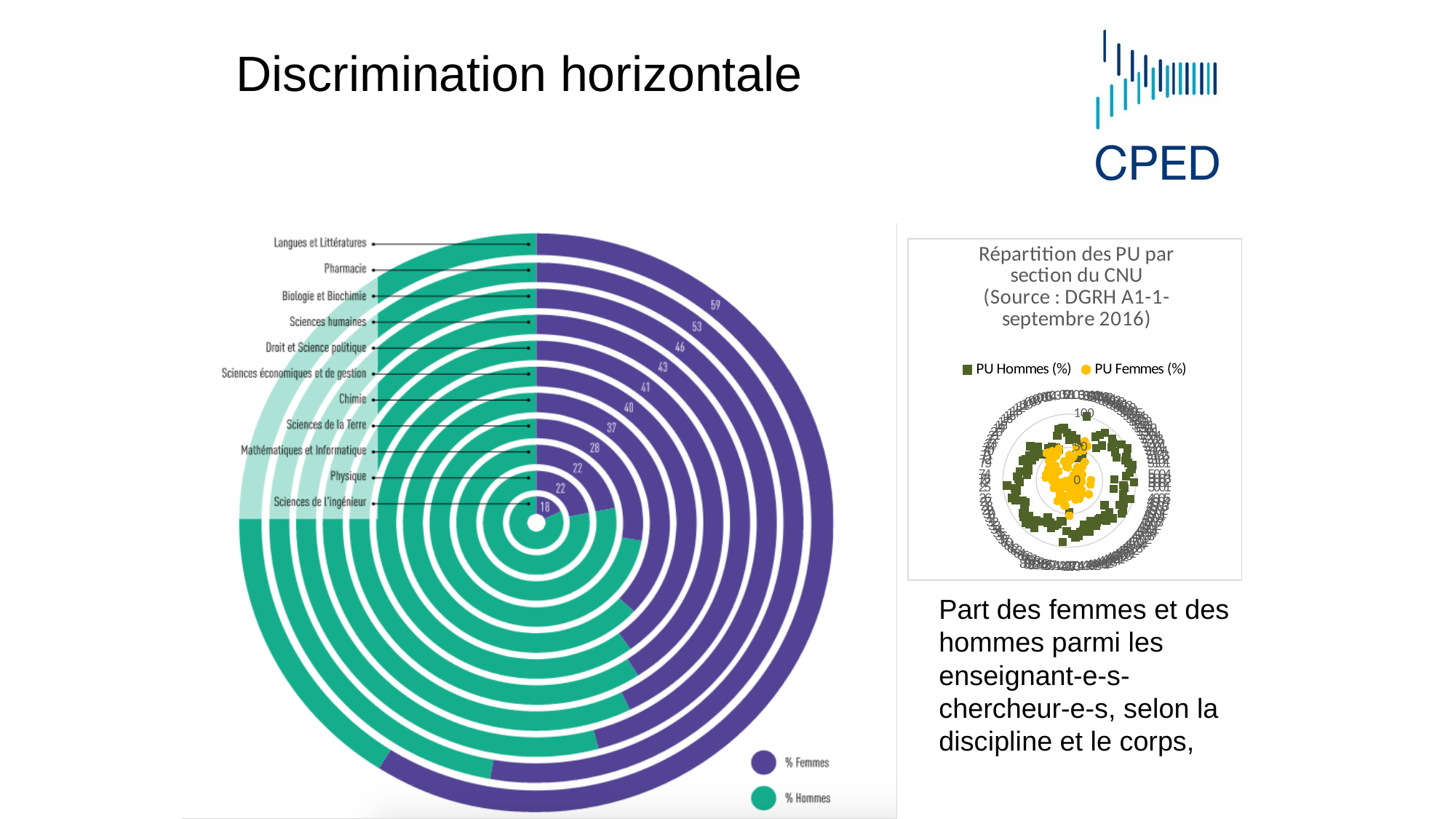
How many series does the legend of the left chart list? 2 On the left chart, which discipline has the highest % Femmes? Langues et Littératures What is the title of the chart on the right? Répartition des PU par section du CNU (Source : DGRH A1-1-septembre 2016) On the left chart, what is the % Femmes value for Chimie? 37 On the left chart, what is the % Femmes value for Langues et Littératures? 59 On the left chart, which has a higher % Femmes, Biologie et Biochimie or Sciences de la Terre? Biologie et Biochimie On the left chart, what is the % Femmes value for Pharmacie? 53 What are the two series listed in the legend of the right chart? PU Hommes (%) and PU Femmes (%) On the left chart, what is the % Femmes value for Sciences de l'ingénieur? 18 How many disciplines are listed on the left chart? 11 On the left chart, which discipline has the lowest % Femmes? Sciences de l'ingénieur On the left chart, what is the difference in % Femmes between Langues et Littératures and Sciences de l'ingénieur? 41